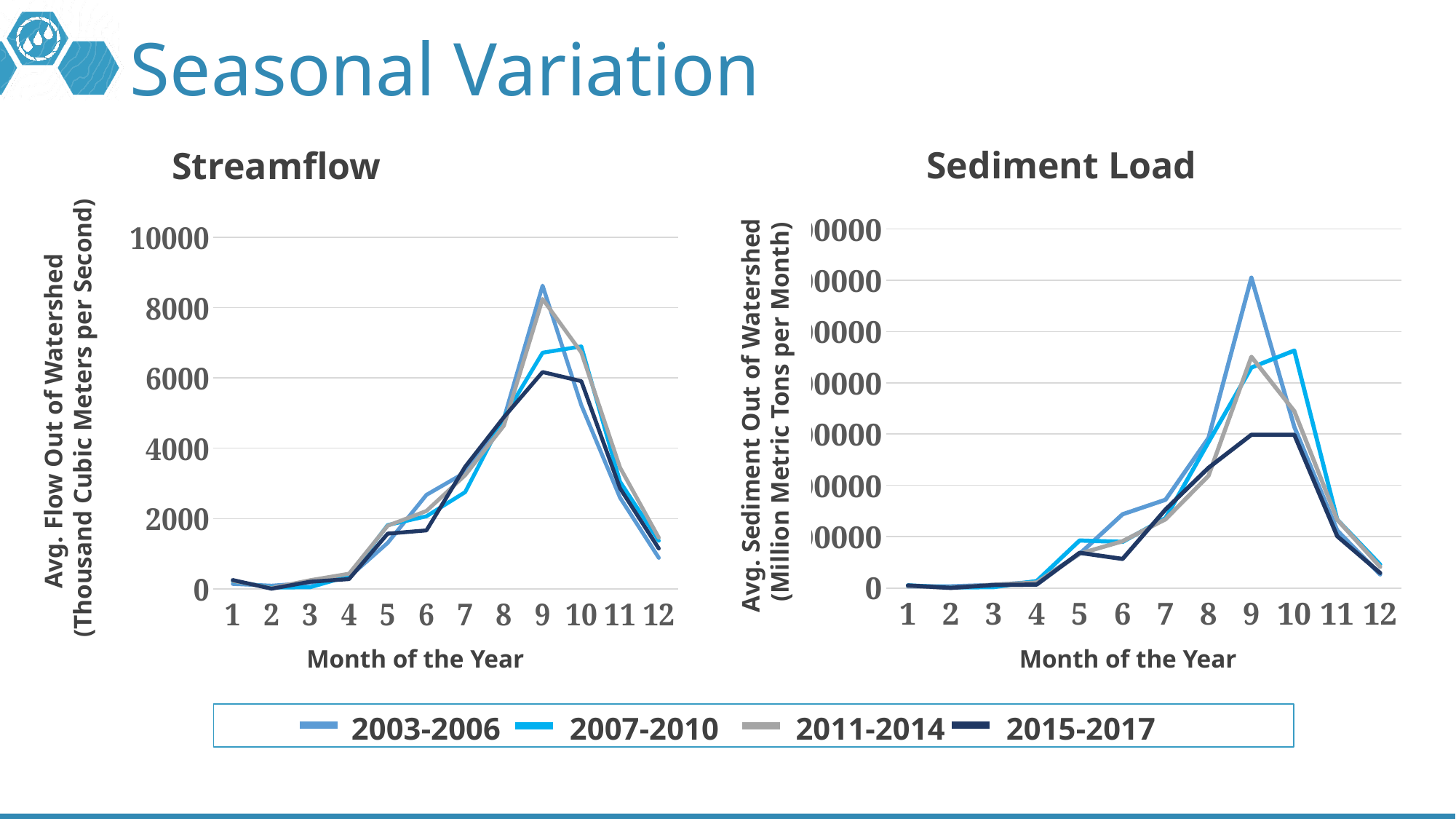
In the Streamflow chart, which series has the lowest value in month 9? 2015-2017 In the Sediment Load chart, in which month does the 2003-2006 series reach its peak? 9 In the Streamflow chart, is the value for 2003-2006 in month 9 greater or less than 8000? greater In the Streamflow chart, is the value for 2015-2017 in month 9 greater or less than 8000? less In the Streamflow chart, is the value for 2007-2010 in month 6 greater or less than 4000? less How many series does the legend list? 4 How many months are plotted along the x axis of the Sediment Load chart? 12 In the Sediment Load chart, which series has the highest value in month 10? 2007-2010 In the Streamflow chart, do the values for 2003-2006 rise or fall from month 9 to month 12? fall In the Streamflow chart, which series has the highest value in month 9? 2003-2006 What is the x-axis title of the Streamflow chart? Month of the Year What kind of chart is the Streamflow chart? line chart